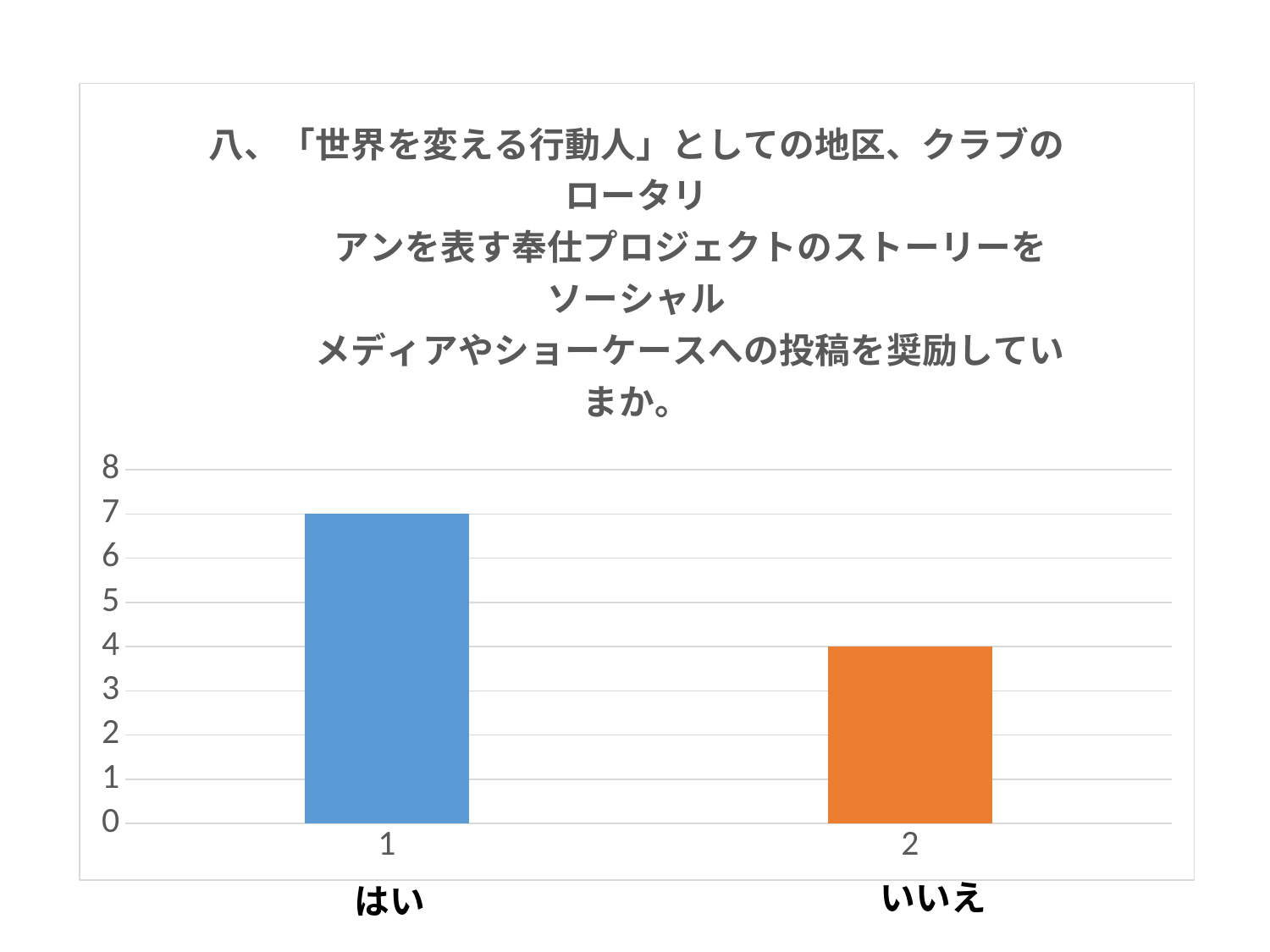
Which category has the lowest bar? 2 (いいえ) What colour is the bar for category 2 (いいえ)? orange What kind of chart is shown on the slide? bar chart What is the maximum value shown on the vertical axis? 8 Is the value for はい greater or less than 6? greater How many bars are plotted in the chart? 2 Which category has the highest bar? 1 (はい) What is the value of the bar for category 1 (はい)? 7 What is the difference between the values for はい and いいえ? 3 Which is larger, the value for はい or the value for いいえ? はい Is the value for いいえ greater or less than 5? less What is the value of the bar for category 2 (いいえ)? 4